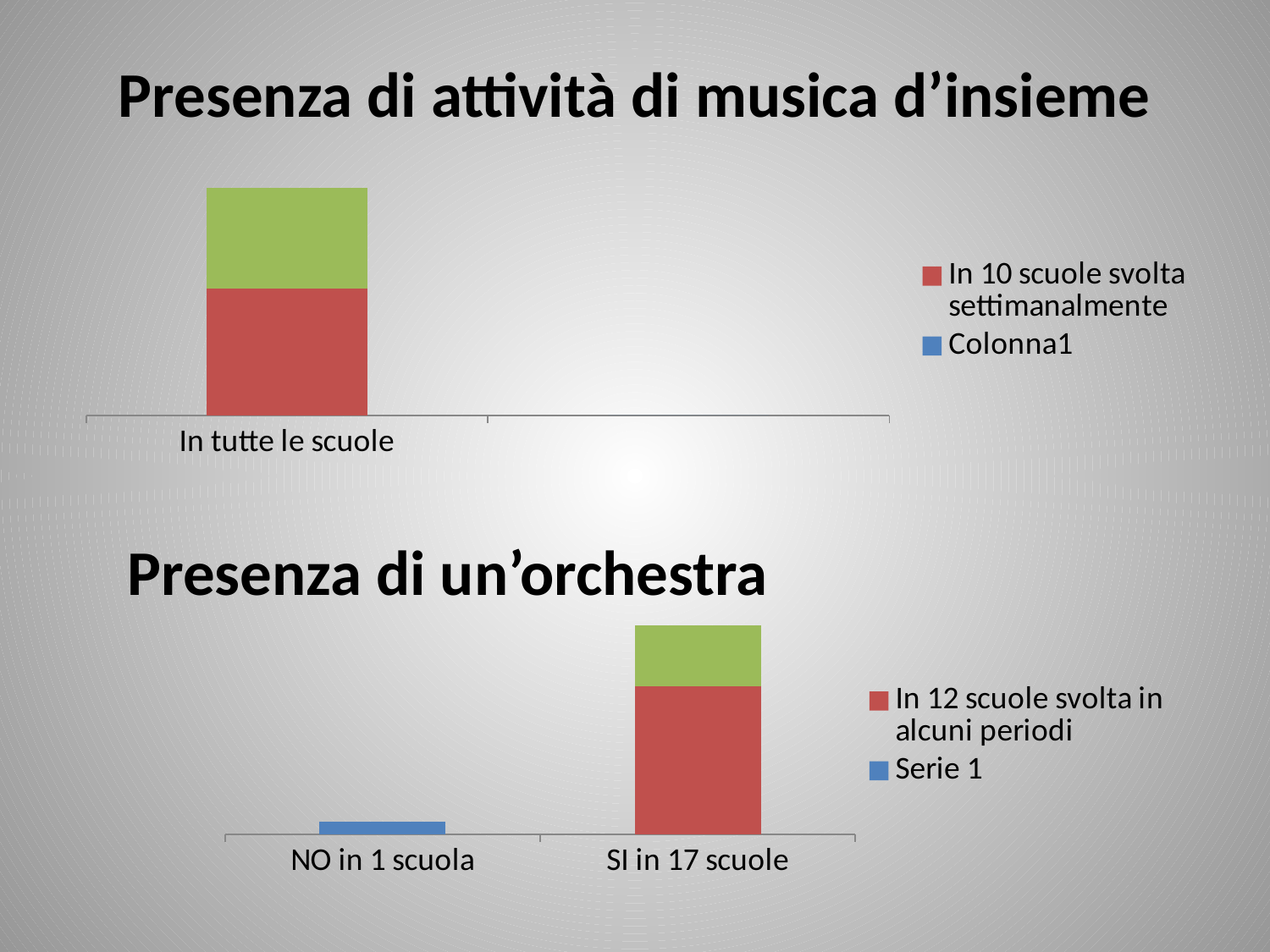
In the bottom chart "Presenza di un'orchestra", what is the first legend entry? In 12 scuole svolta in alcuni periodi What kind of chart is the top chart titled "Presenza di attività di musica d'insieme"? Stacked bar chart In the bottom chart "Presenza di un'orchestra", how many categories are shown on the x axis? 2 In the top chart "Presenza di attività di musica d'insieme", how many categories are shown on the x axis? 1 In the top chart "Presenza di attività di musica d'insieme", how many series does the legend list? 2 In the bottom chart "Presenza di un'orchestra", which category has the shortest bar? NO in 1 scuola In the bottom chart "Presenza di un'orchestra", which category has the tallest bar? SI in 17 scuole In the bottom chart "Presenza di un'orchestra", is the bar for "NO in 1 scuola" or the bar for "SI in 17 scuole" taller? SI in 17 scuole What is the category label on the x axis of the top chart "Presenza di attività di musica d'insieme"? In tutte le scuole In the bottom chart "Presenza di un'orchestra", how many series does the legend list? 2 What kind of chart is the bottom chart titled "Presenza di un'orchestra"? Stacked bar chart